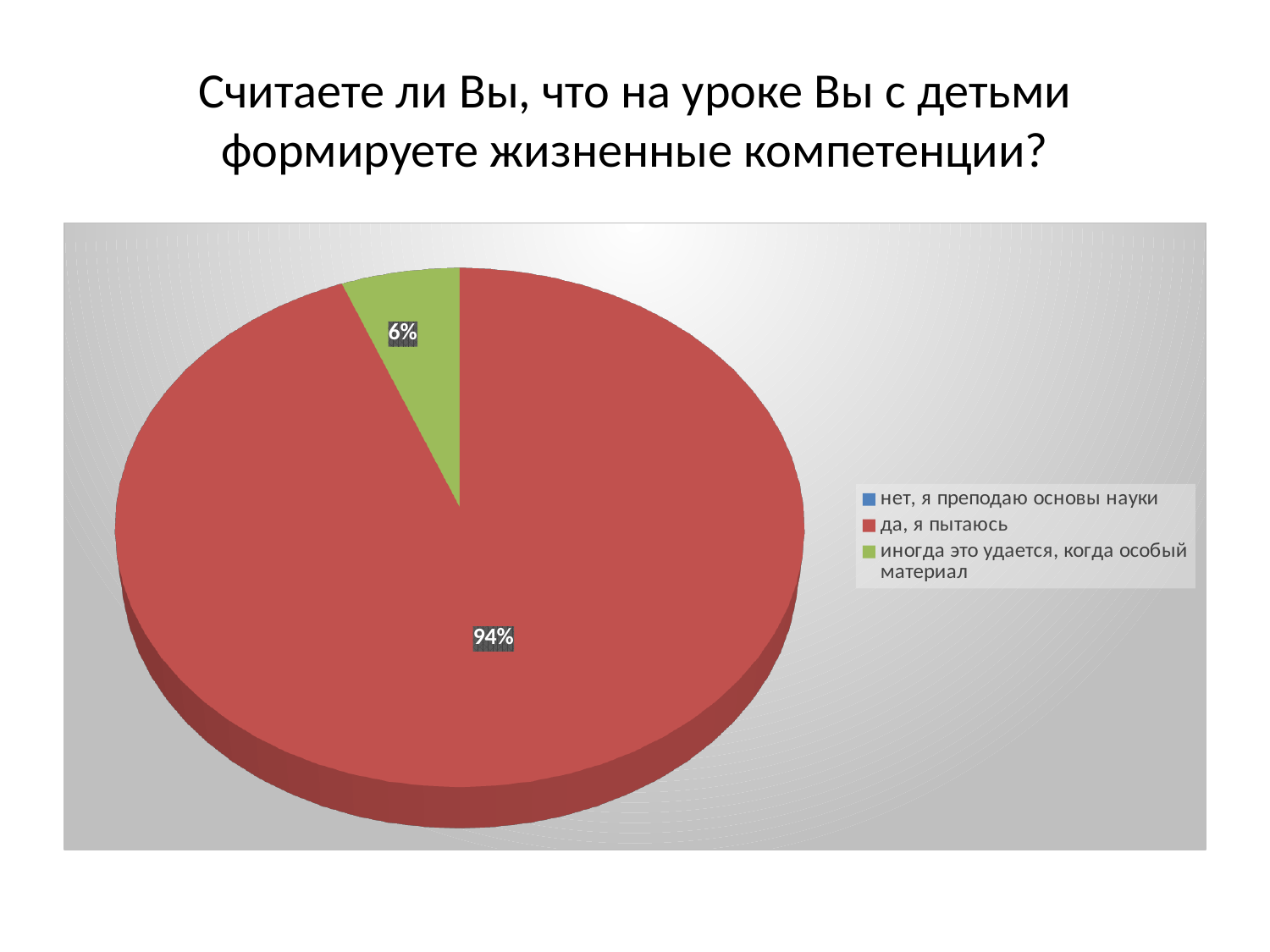
What is the title of the slide above the chart? Считаете ли Вы, что на уроке Вы с детьми формируете жизненные компетенции? What share of the pie does the slice "иногда это удается, когда особый материал" take? 6% How many entries does the legend list? 3 How many slices are visible in the pie? 2 Which is larger: the share for "да, я пытаюсь" or the share for "иногда это удается, когда особый материал"? да, я пытаюсь What colour is the slice for "да, я пытаюсь"? red Which of the two visible slices is smaller, "да, я пытаюсь" or "иногда это удается, когда особый материал"? иногда это удается, когда особый материал What share of the pie does the slice "да, я пытаюсь" take? 94% Which category has the largest slice of the pie? да, я пытаюсь What kind of chart is shown on the slide? pie chart What is the difference in percentage points between the "да, я пытаюсь" slice and the "иногда это удается, когда особый материал" slice? 88